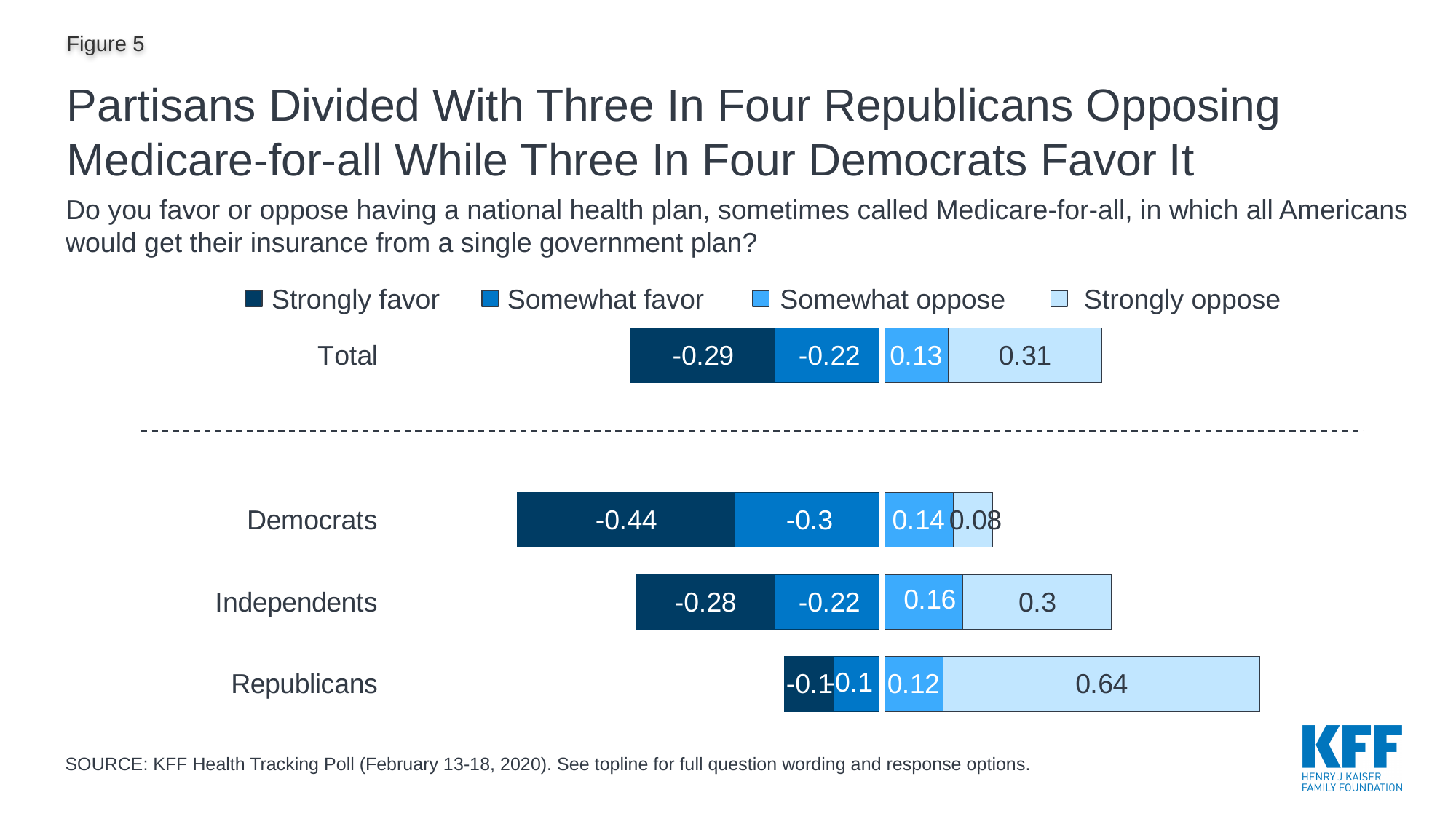
What is the Somewhat favor value for Total? -0.22 What is the difference between the Strongly oppose values for Republicans and Independents? 0.34 Which category has the smallest Strongly oppose value? Democrats What kind of chart is shown on the slide? Stacked bar chart What is the Strongly oppose value for Democrats? 0.08 What is the Strongly favor value for Democrats? -0.44 Which category has the largest Strongly oppose value? Republicans How many series does the legend list? 4 What is the Somewhat oppose value for Independents? 0.16 How many categories are shown on the chart? 4 What is the Strongly oppose value for Republicans? 0.64 Which is larger in magnitude, the Strongly favor value for Democrats or for Independents? Democrats